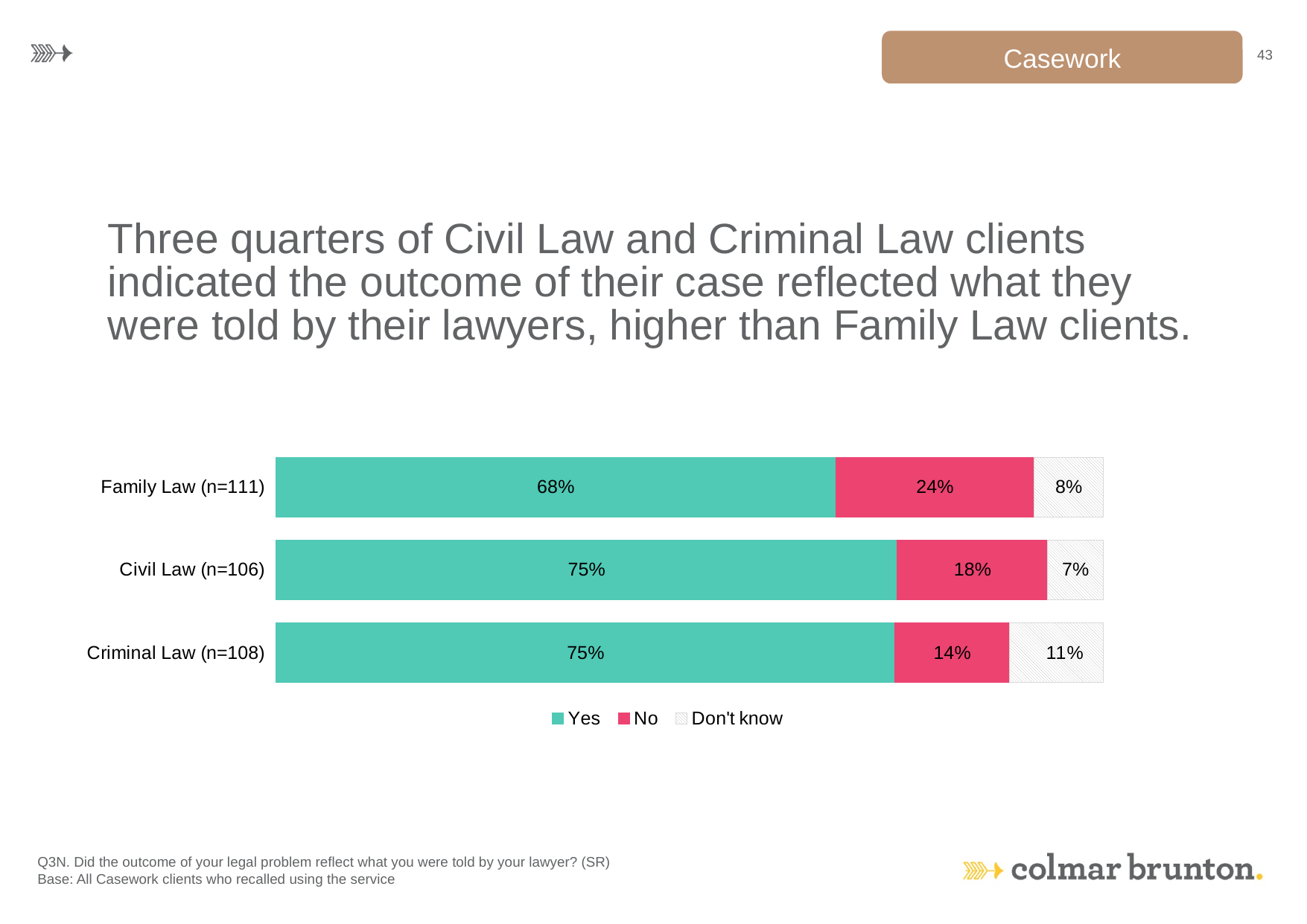
Which category has the highest No percentage? Family Law (n=111) What percentage of Family Law clients answered Yes? 68% What are the legend entries of the chart? Yes, No, Don't know What percentage of Criminal Law clients answered Don't know? 11% How many categories are shown in the chart? 3 What percentage of Civil Law clients answered No? 18% Which is larger: the Yes percentage for Civil Law or for Family Law? Civil Law What is the total of the stacked bar for Family Law? 100% Which category has the lowest Don't know percentage? Civil Law (n=106) How many series does the legend list? 3 What is the difference between the No percentages for Family Law and Criminal Law? 10% What kind of chart is shown on the slide? Stacked bar chart